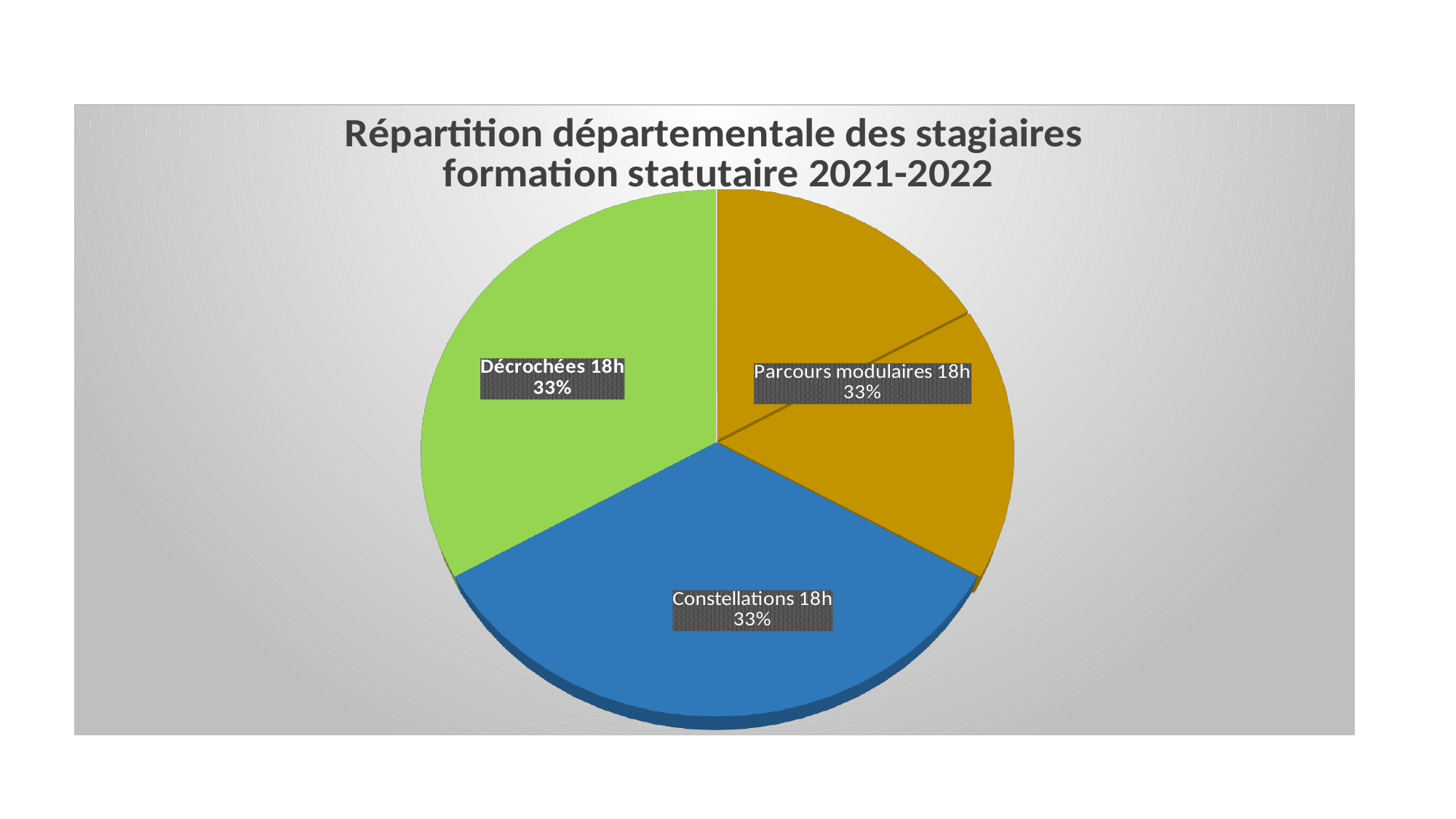
What is the difference between the labelled shares of Décrochées 18h and Constellations 18h? 0% What kind of chart is shown on the slide? pie chart What share of the pie is labelled for Parcours modulaires 18h? 33% What colour is the Constellations 18h slice? blue How many slices does the pie chart have? 4 Which slice is labelled with the name Décrochées 18h? the green slice What share of the pie is labelled for Décrochées 18h? 33% What is the title of the chart? Répartition départementale des stagiaires formation statutaire 2021-2022 What share of the pie is labelled for Constellations 18h? 33%